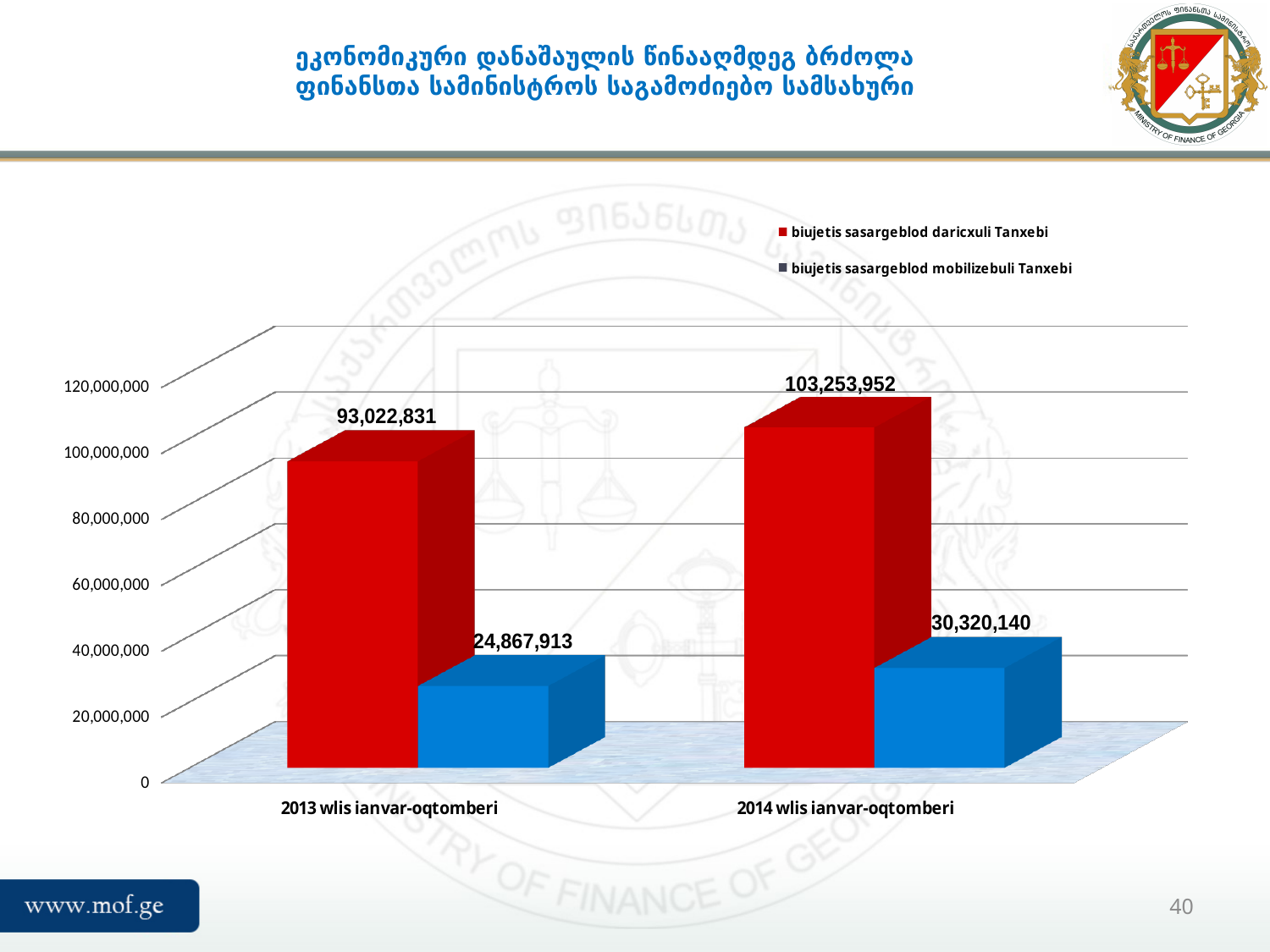
How many series does the legend list? 2 Which category has the highest value for biujetis sasargeblod daricxuli Tanxebi? 2014 wlis ianvar-oqtomberi What is the value of biujetis sasargeblod daricxuli Tanxebi for 2014 wlis ianvar-oqtomberi? 103,253,952 What is the difference between the biujetis sasargeblod daricxuli Tanxebi values for 2014 and 2013 wlis ianvar-oqtomberi? 10,231,121 What is the value of biujetis sasargeblod mobilizebuli Tanxebi for 2014 wlis ianvar-oqtomberi? 30,320,140 What kind of chart is shown on the slide? Bar chart Which is larger for 2013 wlis ianvar-oqtomberi: biujetis sasargeblod daricxuli Tanxebi or biujetis sasargeblod mobilizebuli Tanxebi? biujetis sasargeblod daricxuli Tanxebi What is the value of biujetis sasargeblod daricxuli Tanxebi for 2013 wlis ianvar-oqtomberi? 93,022,831 Which category has the lowest value for biujetis sasargeblod mobilizebuli Tanxebi? 2013 wlis ianvar-oqtomberi What is the difference between the biujetis sasargeblod mobilizebuli Tanxebi values for 2014 and 2013 wlis ianvar-oqtomberi? 5,452,227 What is the value of biujetis sasargeblod mobilizebuli Tanxebi for 2013 wlis ianvar-oqtomberi? 24,867,913 How many categories are shown on the x axis? 2